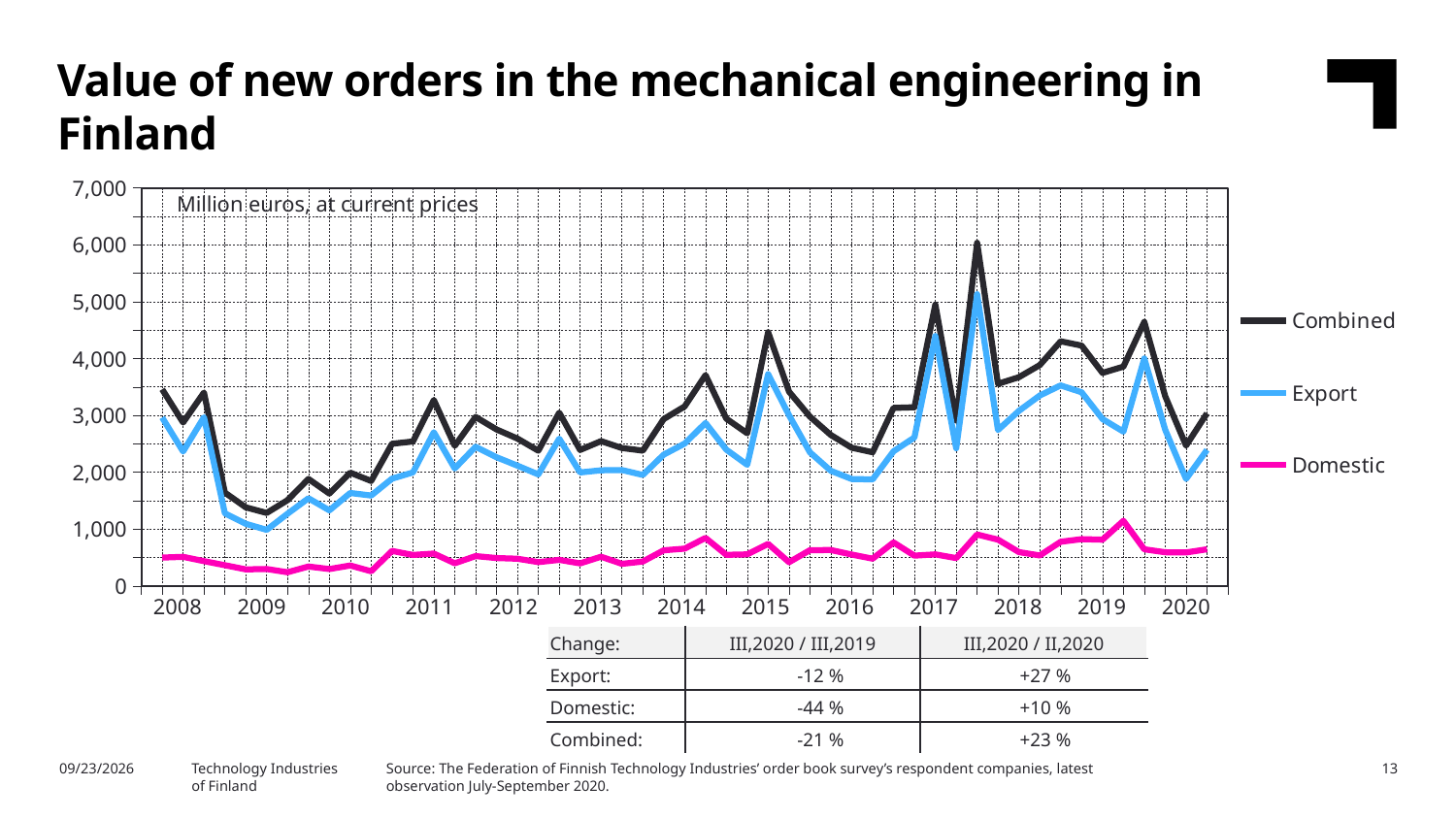
What kind of chart is shown on the slide? line chart Which series is plotted with the lowest values throughout the chart? Domestic Is the peak value of the Combined series in 2017 greater or less than 5,000? greater According to the table below the chart, what is the Domestic change for III,2020 / II,2020? +10 % How many series does the chart legend list? 3 What unit is stated inside the chart area? Million euros, at current prices According to the table below the chart, what is the Export change for III,2020 / III,2019? -12 % Is the value of the Export series at the start of 2009 greater or less than 2,000? less Is the value of the Domestic series at the start of 2008 greater or less than 1,000? less Which series is plotted with the highest values throughout the chart? Combined Does the Combined series rise or fall between the start of 2008 and the start of 2009? fall According to the table below the chart, what is the Combined change for III,2020 / III,2019? -21 %